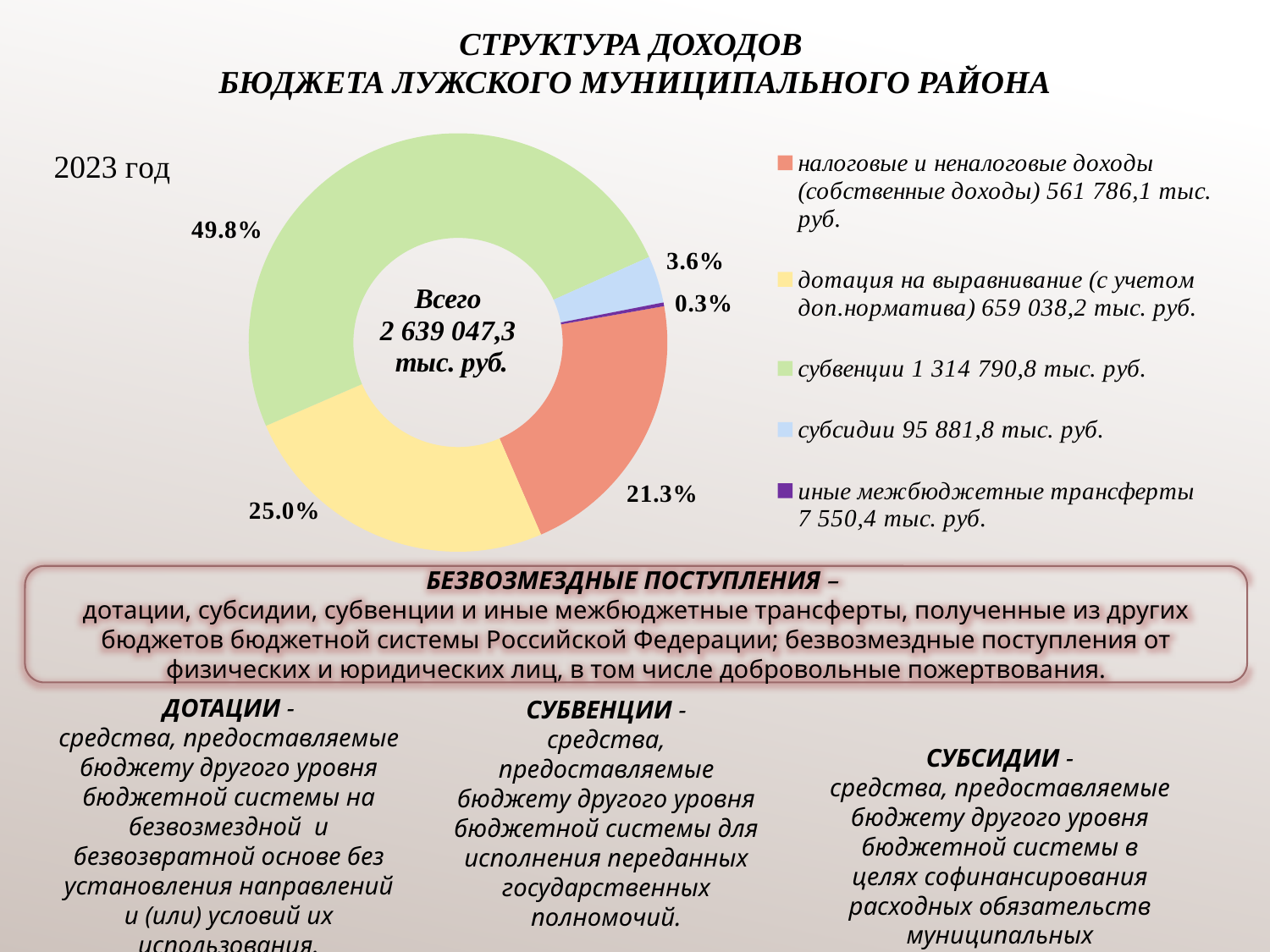
What kind of chart is shown on the slide? Pie (donut) chart What share of the pie does the 'субсидии' slice take? 3.6% What is the difference in percentage points between the 'субвенции' share and the 'дотация на выравнивание' share? 24.8 What share of the pie does the 'дотация на выравнивание' slice take? 25.0% Which category has the largest share of the pie? субвенции How many categories does the legend of the chart list? 5 What total value is printed in the centre of the donut chart? 2 639 047,3 тыс. руб. What share of the pie does the 'налоговые и неналоговые доходы (собственные доходы)' slice take? 21.3% Which category has the smallest share of the pie? иные межбюджетные трансферты Which is larger: the share for 'дотация на выравнивание' or the share for 'налоговые и неналоговые доходы'? дотация на выравнивание What value in тыс. руб. does the legend give for 'субсидии'? 95 881,8 тыс. руб.